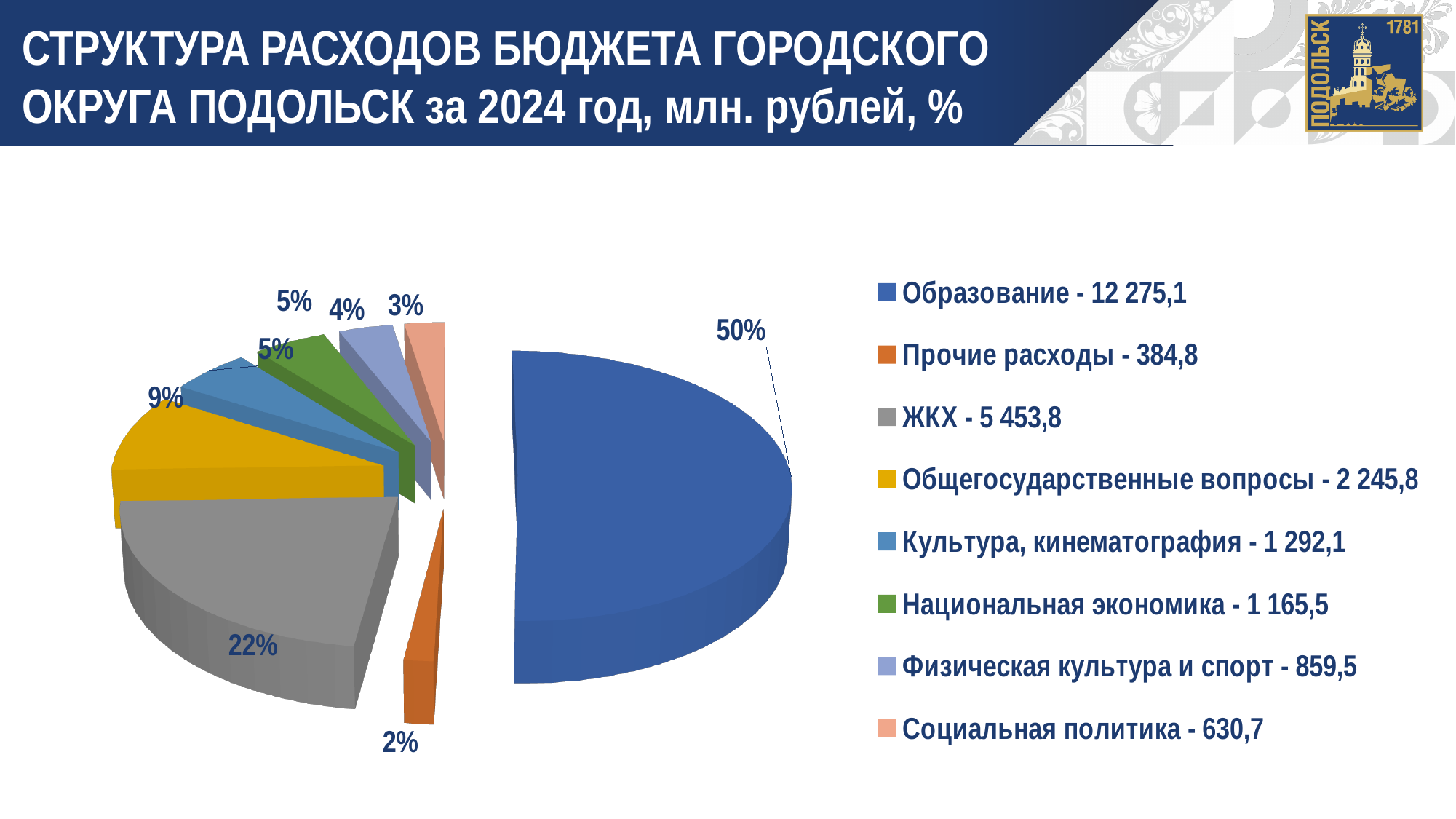
What value (in million rubles) is given for Социальная политика in the legend? 630,7 Which category has the largest share of the pie? Образование What kind of chart is shown on the slide? Pie chart What value (in million rubles) is given for ЖКХ in the legend? 5 453,8 What share of the pie does Прочие расходы account for? 2% Which category has the smallest share of the pie? Прочие расходы What share of the pie does ЖКХ account for? 22% What share of the pie does Образование account for? 50% How many categories does the legend of the pie chart list? 8 What is the difference in percentage points between the share of Образование and the share of ЖКХ? 28% What colour is the slice for Общегосударственные вопросы? Yellow Which is larger: the value for Общегосударственные вопросы or the value for Культура, кинематография? Общегосударственные вопросы